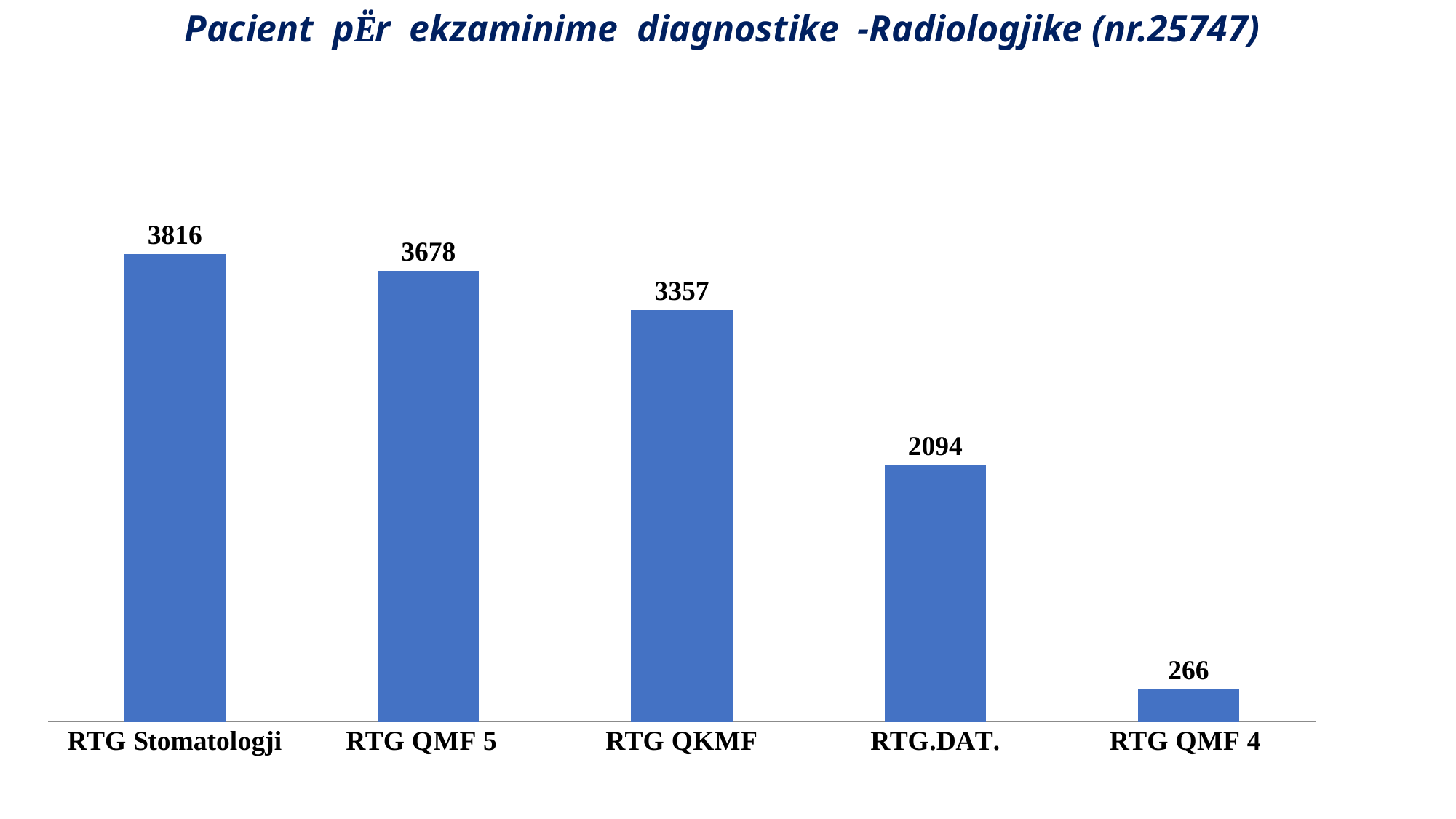
What is the difference between the values for RTG Stomatologji and RTG QMF 5? 138 Which is larger, the value for RTG QKMF or the value for RTG.DAT.? RTG QKMF What is the value for RTG QMF 4? 266 How many categories are shown in the chart? 5 What is the difference between the values for RTG QKMF and RTG.DAT.? 1263 What kind of chart is shown on the slide? bar chart What is the value for RTG Stomatologji? 3816 What is the value for RTG.DAT.? 2094 Do the values rise or fall from left to right along the x axis? fall Which category has the highest value? RTG Stomatologji What is the value for RTG QMF 5? 3678 Which category has the lowest value? RTG QMF 4